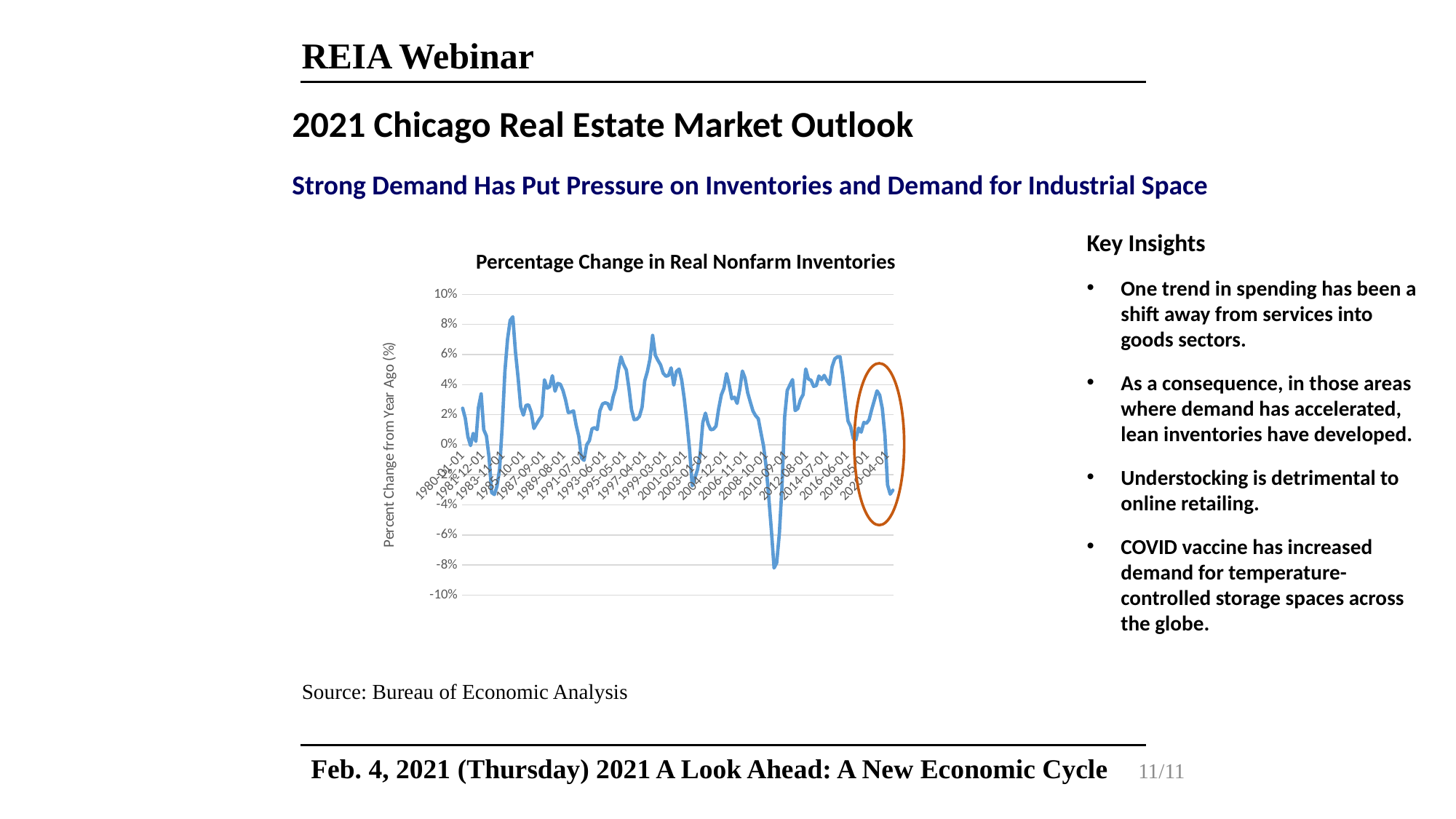
Which is higher: the peak in the mid-1980s or the peak around 1999? the peak in the mid-1980s How many lines (data series) are plotted on the chart? 1 Which trough is lower: the one around 2009-2010 or the one around 1983? the one around 2009-2010 Is the lowest point of the line, around 2009-2010, greater or less than -6%? less What is the title of the chart? Percentage Change in Real Nonfarm Inventories What is the label on the vertical axis of the chart? Percent Change from Year Ago (%) Is the peak of the line around 2016-2017 greater or less than 4%? greater Is the highest peak of the line, in the mid-1980s, greater or less than 6%? greater Does the line rise or fall in the circled region at the far right of the chart (2020)? fall What kind of chart is shown on the slide? line chart